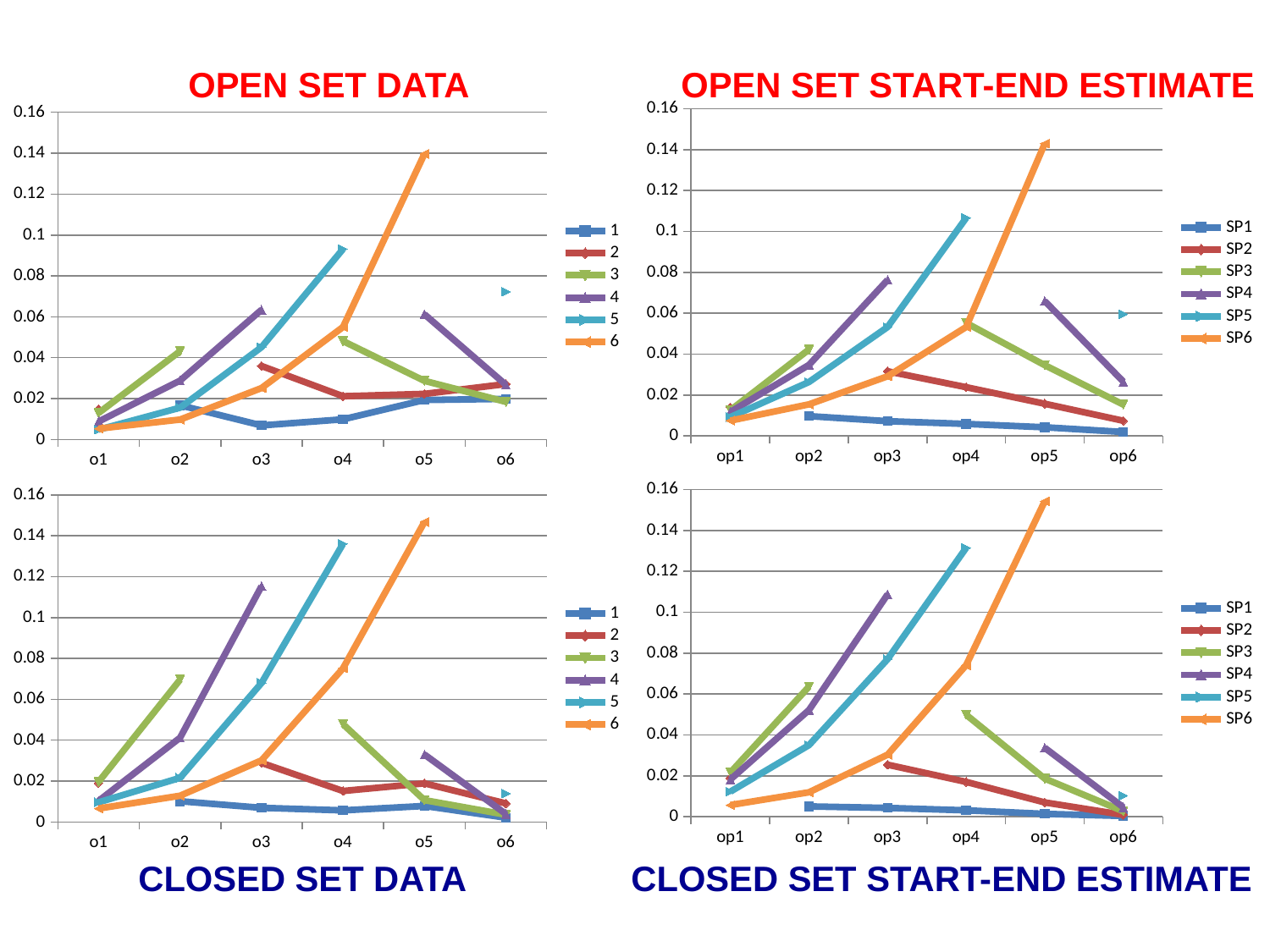
In the CLOSED SET DATA chart, is the value of series 5 at o4 greater or less than 0.12? greater How many categories are on the x axis of the CLOSED SET START-END ESTIMATE chart? 6 In the CLOSED SET START-END ESTIMATE chart, is the value of SP6 at op5 greater or less than 0.14? greater In the OPEN SET DATA chart, is the value of series 6 at o5 greater or less than 0.12? greater In the OPEN SET START-END ESTIMATE chart, does the SP1 line rise or fall from op2 to op6? fall In the CLOSED SET DATA chart, at o3, which is larger: series 4 or series 5? series 4 How many series does the legend of the OPEN SET START-END ESTIMATE chart list? 6 How many series does the legend of the OPEN SET DATA chart list? 6 What kind of chart is the OPEN SET DATA chart? line chart How many categories are on the x axis of the OPEN SET DATA chart? 6 In the OPEN SET DATA chart, which series reaches the highest value? 6